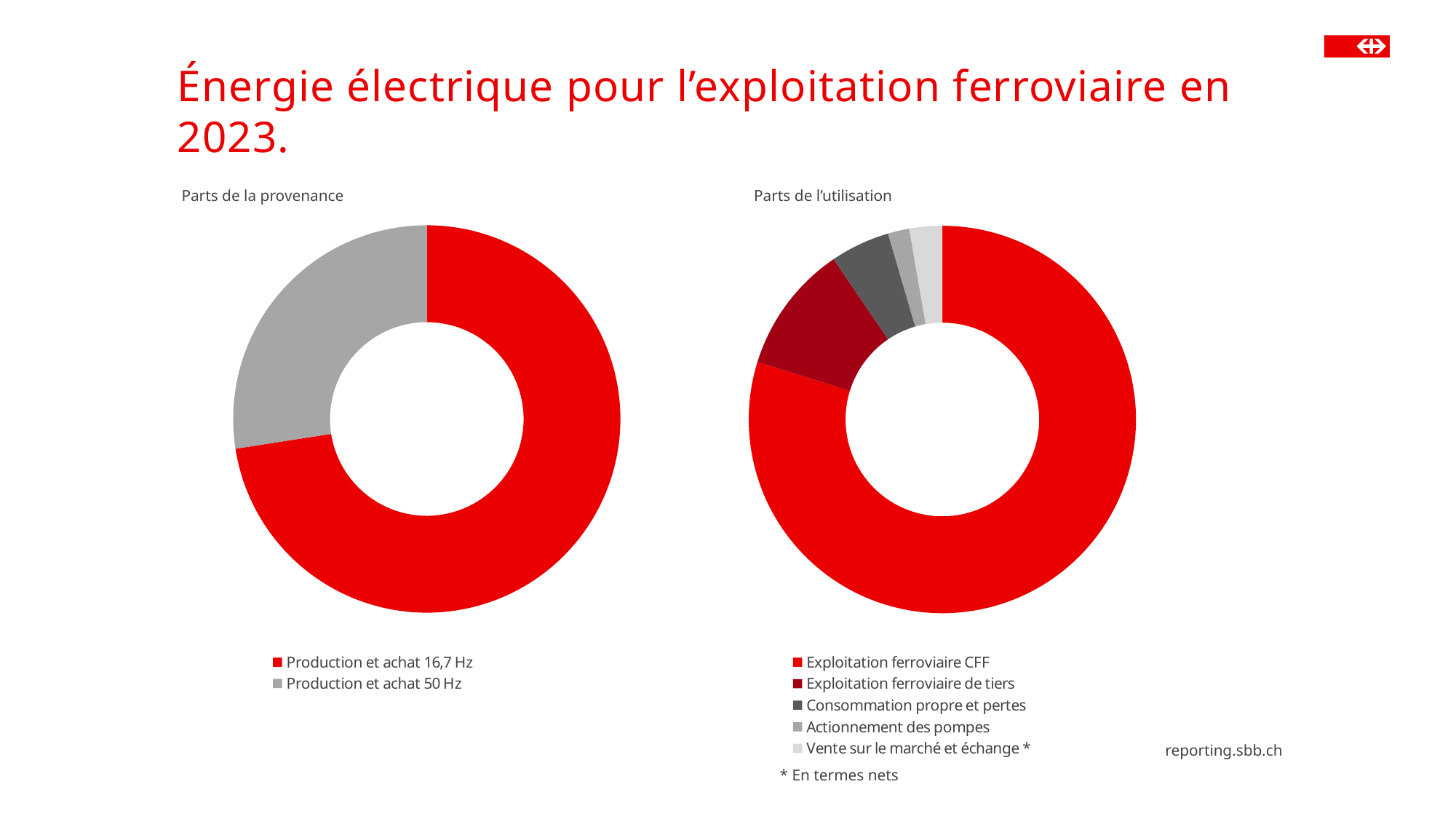
What kind of chart is the 'Parts de la provenance' chart? Pie chart (donut) In the 'Parts de l'utilisation' chart, which is larger: Exploitation ferroviaire de tiers or Consommation propre et pertes? Exploitation ferroviaire de tiers What is the title of the chart on the right side of the slide? Parts de l'utilisation In the 'Parts de l'utilisation' chart, which category has the largest share? Exploitation ferroviaire CFF How many entries does the legend of the 'Parts de l'utilisation' chart list? 5 How many slices does the 'Parts de la provenance' chart have? 2 In the 'Parts de la provenance' chart, which category has the smallest share? Production et achat 50 Hz How many entries does the legend of the 'Parts de la provenance' chart list? 2 In the 'Parts de la provenance' chart, which category has the largest share? Production et achat 16,7 Hz What kind of chart is the 'Parts de l'utilisation' chart? Pie chart (donut) In the 'Parts de la provenance' chart, which is larger: Production et achat 16,7 Hz or Production et achat 50 Hz? Production et achat 16,7 Hz How many slices does the 'Parts de l'utilisation' chart have? 5